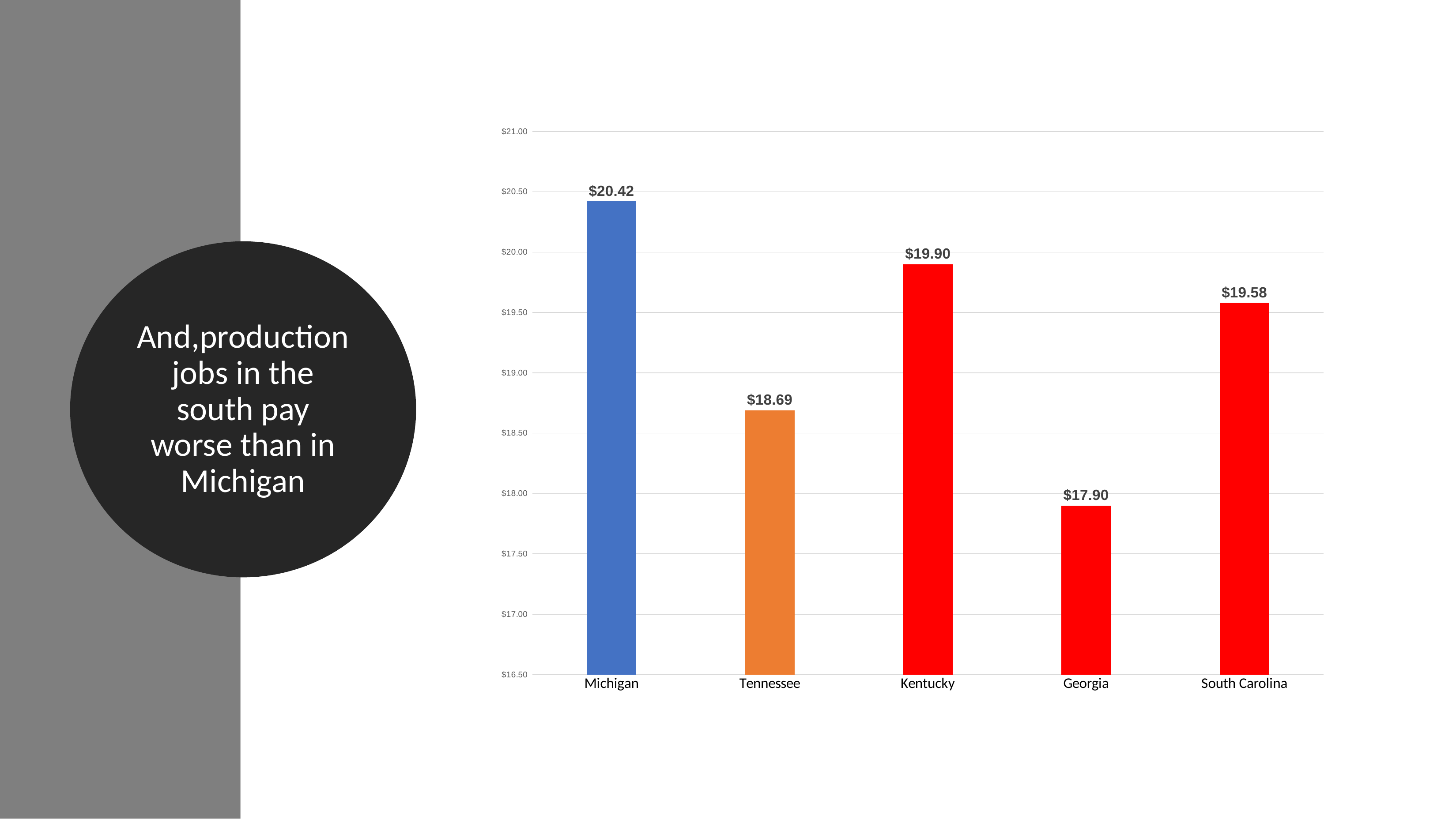
What is the difference between the values for Kentucky and South Carolina? $0.32 What is the value for South Carolina? $19.58 What is the value for Tennessee? $18.69 Which is larger, the value for Kentucky or the value for Tennessee? Kentucky Which state has the lowest value? Georgia How many states are shown on the chart? 5 What kind of chart is shown on the slide? bar chart What is the value for Michigan? $20.42 Is the value for Tennessee greater or less than $19.00? less What is the value for Georgia? $17.90 What is the difference between the values for Michigan and Georgia? $2.52 Which state has the highest value? Michigan